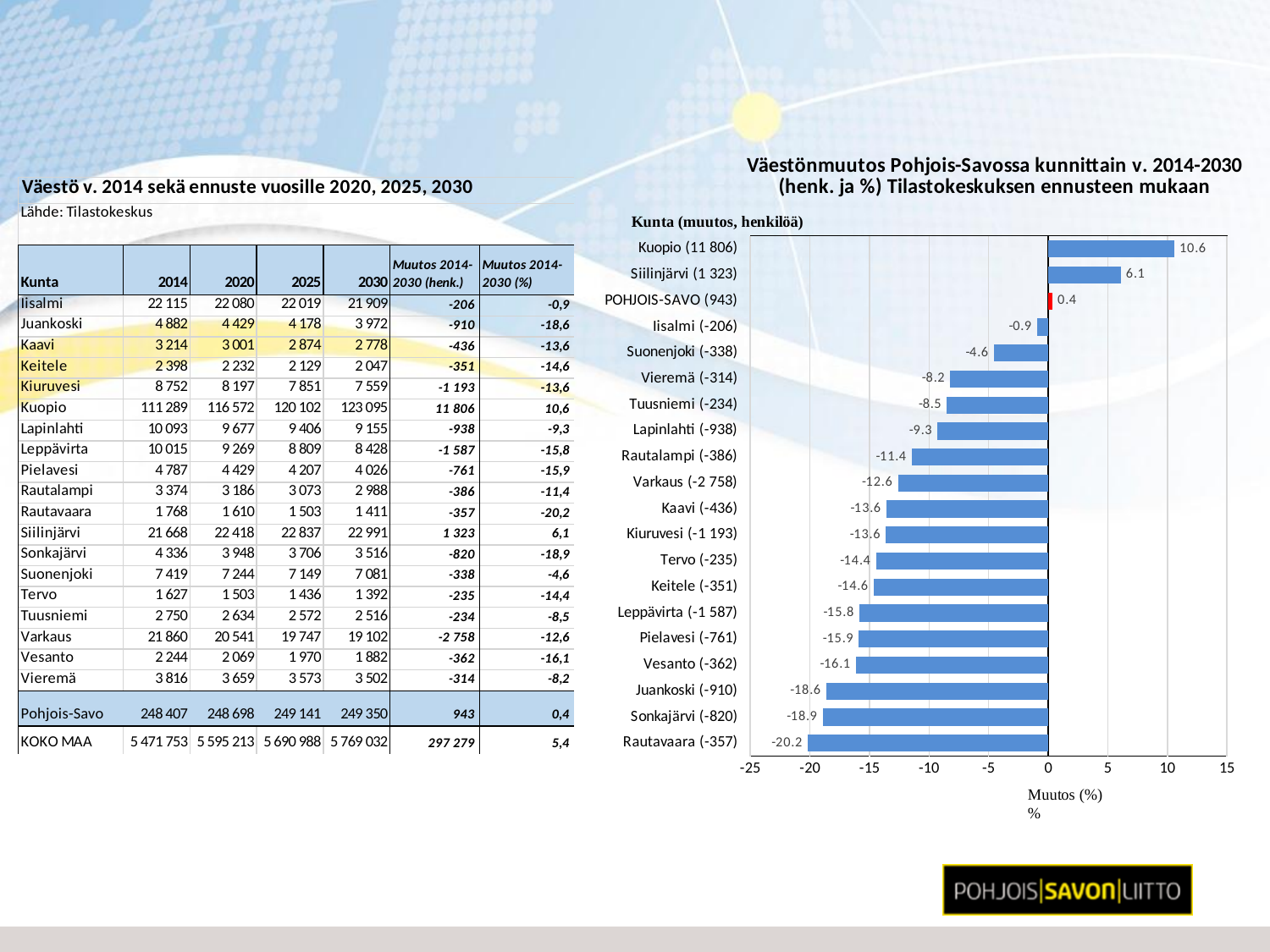
In the bar chart, what is the value shown for Varkaus (-2 758)? -12.6 In the bar chart, what is the difference between the values for Kuopio (11 806) and Siilinjärvi (1 323)? 4.5 In the bar chart, what is the percentage change shown for Kuopio (11 806)? 10.6 How many bars are plotted in the bar chart? 20 Which category has the lowest value in the bar chart? Rautavaara (-357) What is the x-axis label of the bar chart? Muutos (%) In the bar chart, what is the percentage change shown for Rautavaara (-357)? -20.2 In the bar chart, what is the value shown for POHJOIS-SAVO (943)? 0.4 What type of chart is shown on the right side of the slide? bar chart Which category has the highest value in the bar chart? Kuopio (11 806) In the bar chart, what is the value shown for Siilinjärvi (1 323)? 6.1 In the bar chart, which has a larger value, Suonenjoki (-338) or Vieremä (-314)? Suonenjoki (-338)